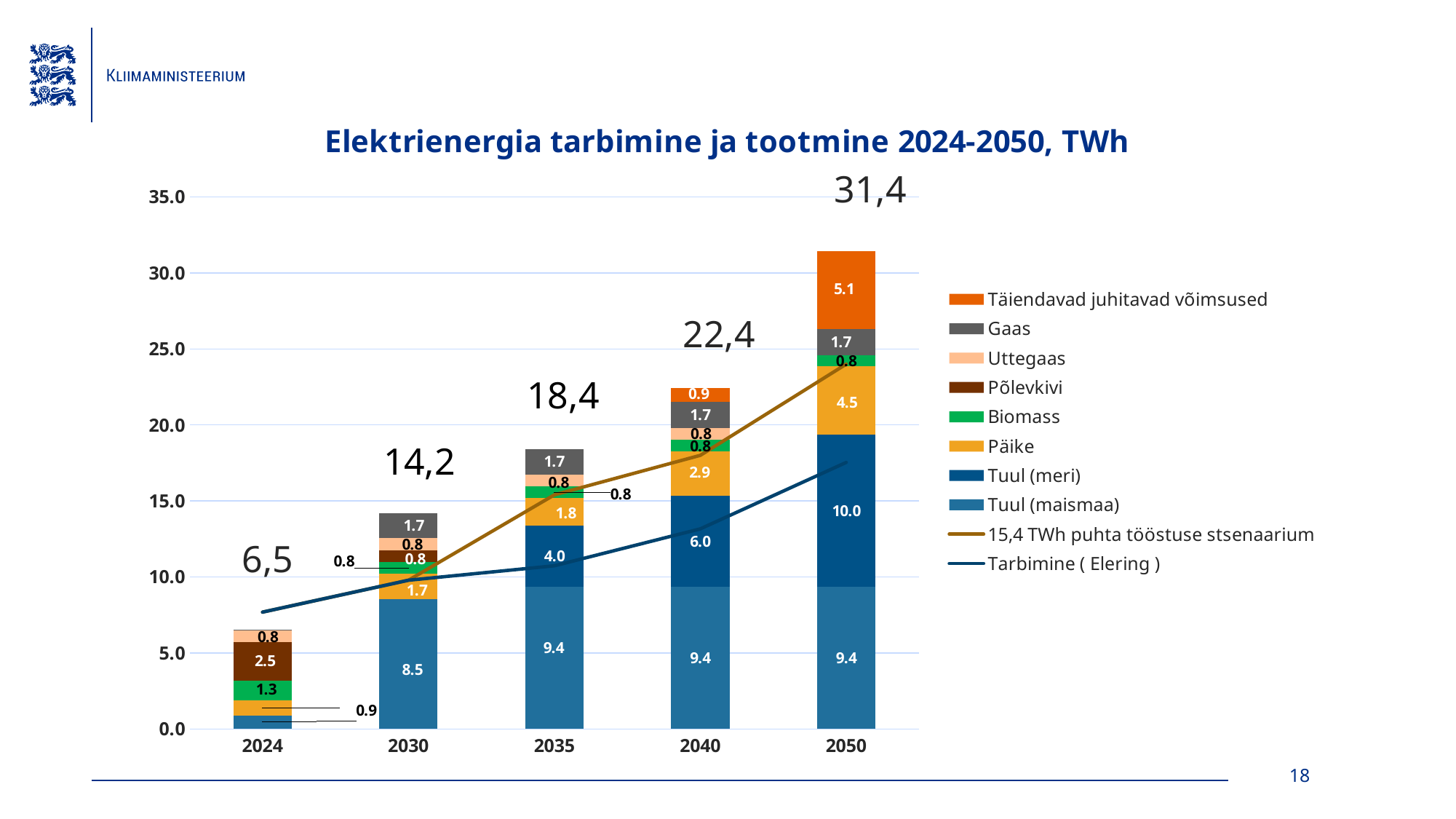
Which year has the highest total bar? 2050 What is the value of Tuul (meri) in 2050? 10.0 How many entries does the legend list? 10 What is the total labelled above the bar for 2050? 31,4 What is the total labelled above the bar for 2024? 6,5 What is the value of Põlevkivi in 2024? 2.5 Which year has the lowest total bar? 2024 What is the value of Päike in 2040? 2.9 What is the value of Täiendavad juhitavad võimsused in 2050? 5.1 What kind of chart is shown on the slide? Stacked bar chart with line series How much larger is Tuul (meri) in 2050 than in 2040? 4.0 How many years are shown on the x axis? 5